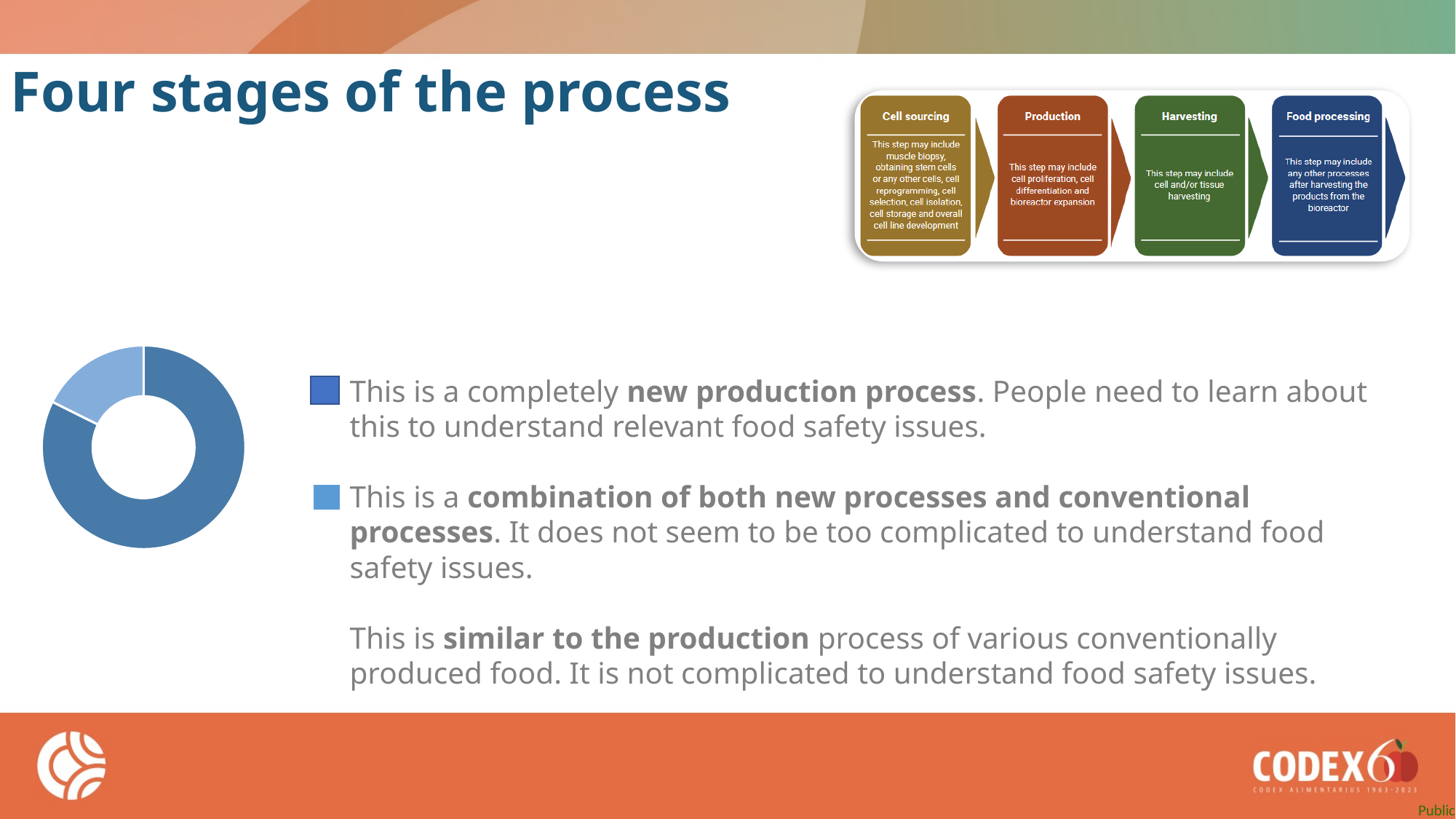
In the doughnut chart, is the dark blue slice or the light blue slice larger? The dark blue slice Which colour in the doughnut chart represents the 'completely new production process' category? Dark blue Which slice of the doughnut chart is the smallest? The light blue slice (combination of both new processes and conventional processes) What kind of chart is shown on the left of the slide? Doughnut chart How many slices does the doughnut chart have? 2 Which slice of the doughnut chart is the largest? The dark blue slice (new production process) Which colour in the doughnut chart represents the 'combination of both new processes and conventional processes' category? Light blue